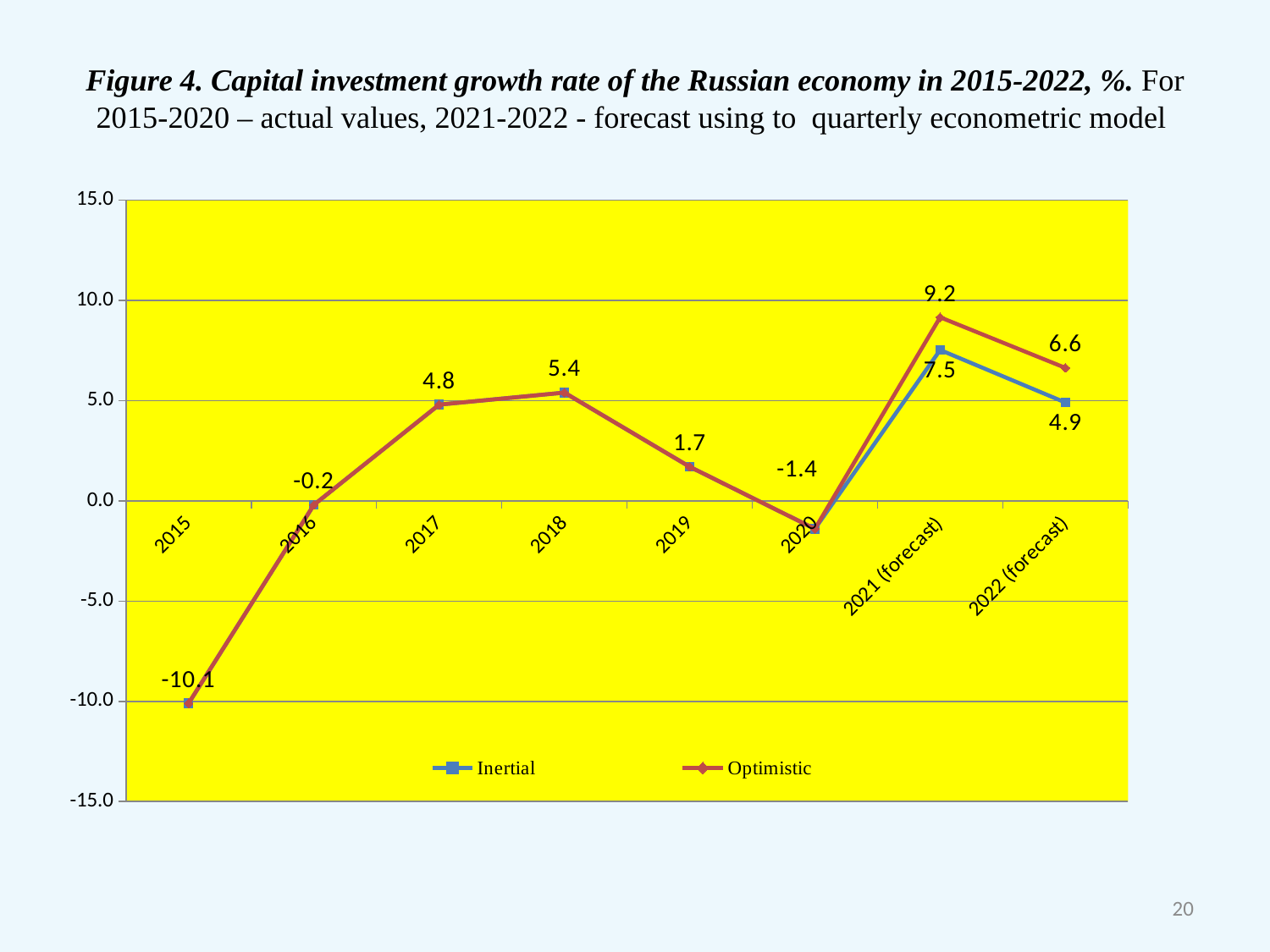
Which year has the lowest value on the chart? 2015 What is the difference between the Optimistic and Inertial values for 2021 (forecast)? 1.7 Which is larger for 2022 (forecast): the Inertial value or the Optimistic value? Optimistic What is the Optimistic forecast value for 2021? 9.2 How many series does the legend list? 2 What is the value for 2018? 5.4 Which point has the highest value on the chart? 2021 (forecast), Optimistic How many years are shown on the x axis? 8 What is the capital investment growth rate for 2015? -10.1 What is the Inertial forecast value for 2022? 4.9 What kind of chart is shown on the slide? line chart Do the values rise or fall from 2018 to 2020? fall